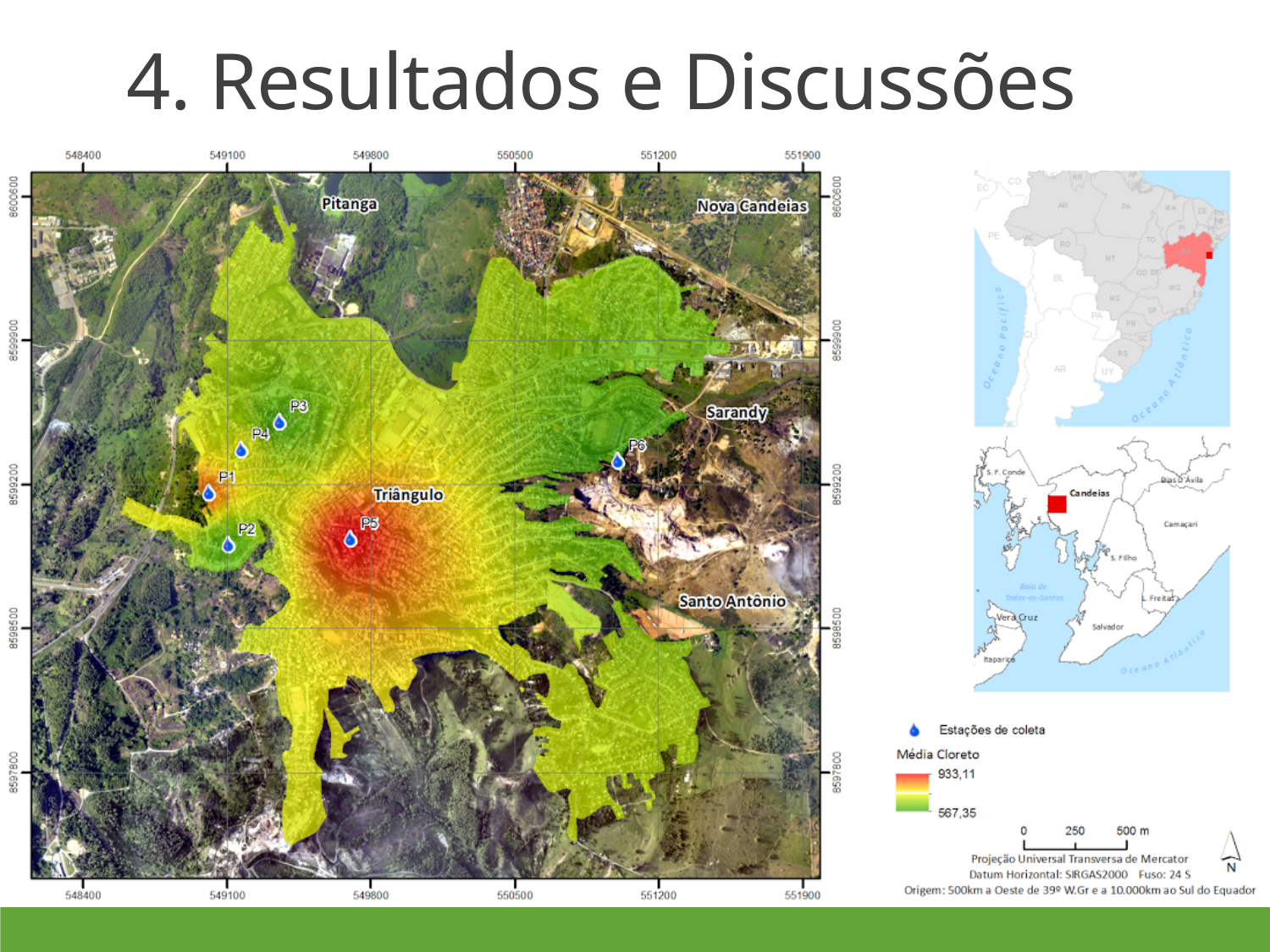
Is the maximum value on the 'Média Cloreto' legend greater or less than 900? greater What is the largest distance labelled on the map's scale bar? 500 m How many collection stations (Estações de coleta) are marked on the map? 6 Which colour on the legend represents the lowest 'Média Cloreto' value? Green Is the minimum value on the 'Média Cloreto' legend greater or less than 600? less What is the minimum value shown on the 'Média Cloreto' colour scale legend? 567,35 What is the maximum value shown on the 'Média Cloreto' colour scale legend? 933,11 Which neighbourhood label is closest to station P5? Triângulo What kind of visualisation is shown on the slide? Map Which collection station is located in the red (highest chloride) area of the map? P5 What is the difference between the maximum and minimum values on the 'Média Cloreto' colour scale? 365,76 Which colour on the legend represents the highest 'Média Cloreto' value? Red